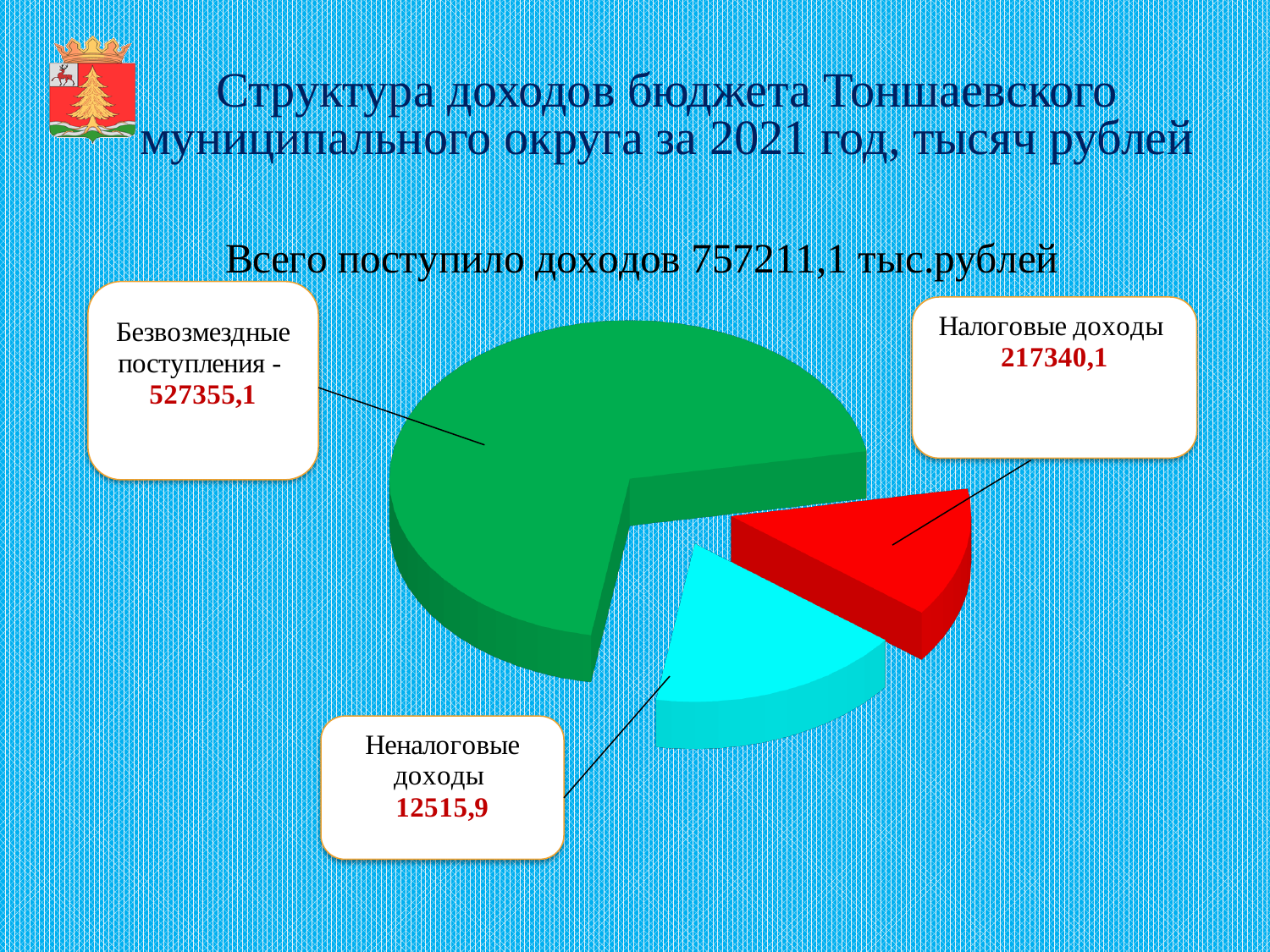
What is the value for Безвозмездные поступления on the pie chart? 527355,1 What is the total income shown on the slide, in thousand rubles? 757211,1 How many slices does the pie chart have? 3 What is the value for Неналоговые доходы on the pie chart? 12515,9 What is the difference between Безвозмездные поступления and Налоговые доходы? 310015,0 Which category has the largest slice of the pie chart? Безвозмездные поступления What is the difference between Налоговые доходы and Неналоговые доходы? 204824,2 What is the value for Налоговые доходы on the pie chart? 217340,1 What colour is the slice for Налоговые доходы? Red What kind of chart is shown on the slide? Pie chart Which is larger, Налоговые доходы or Неналоговые доходы? Налоговые доходы